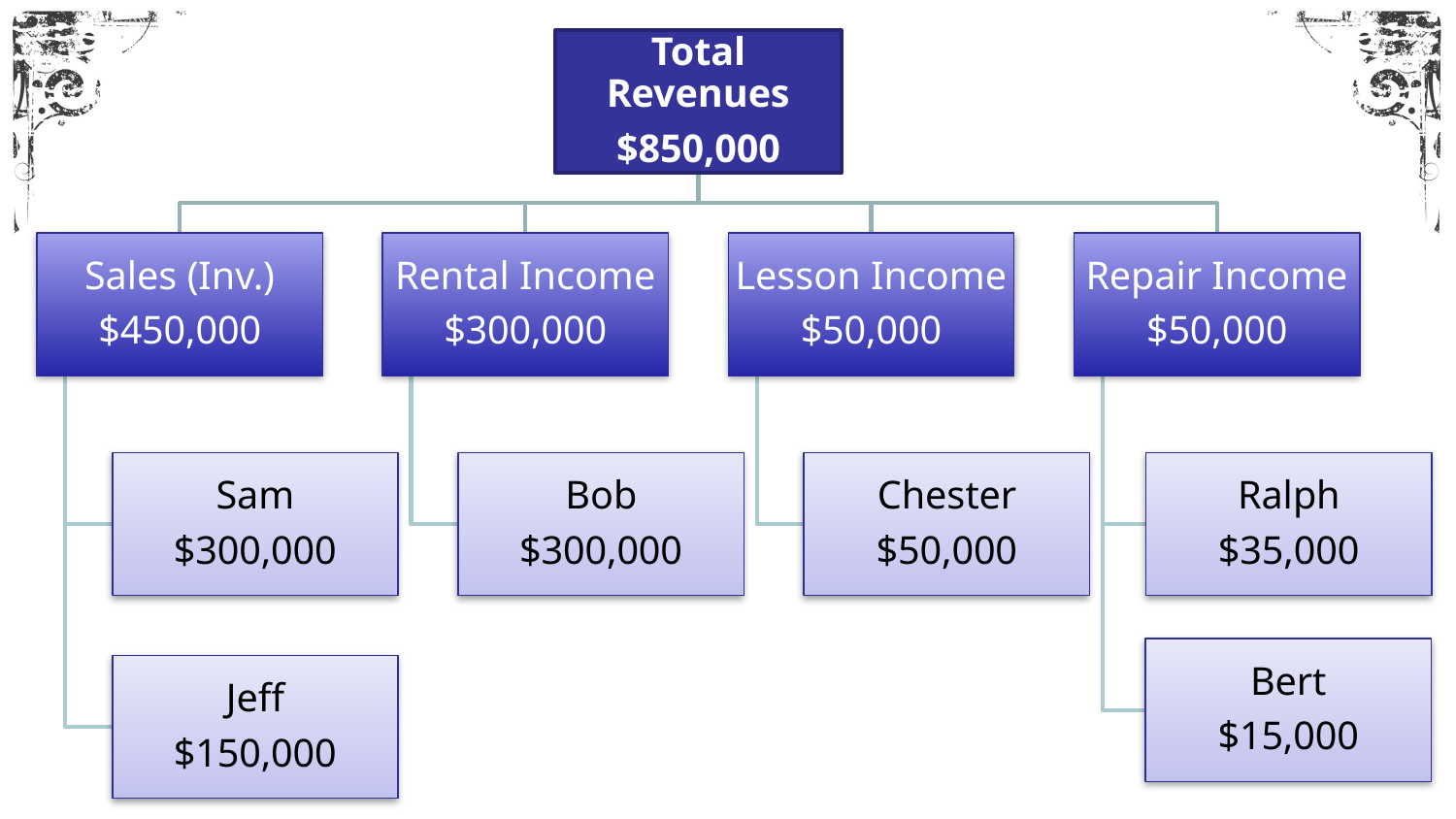
Which person has the lowest value in the diagram? Bert What is the value shown for Rental Income? $300,000 Which of the four income categories has the highest value? Sales (Inv.) What is the value shown for Bert under Repair Income? $15,000 What is the Total Revenues value shown at the top of the diagram? $850,000 Which is larger, Sam's value or Jeff's value? Sam What is the value shown for Jeff under Sales (Inv.)? $150,000 What is the difference between the Sales (Inv.) value and the Rental Income value? $150,000 What is the difference between Ralph's value and Bert's value? $20,000 What is the value shown for Sales (Inv.)? $450,000 How many people are shown in the bottom level of the diagram? 6 How many income categories are shown directly under Total Revenues? 4